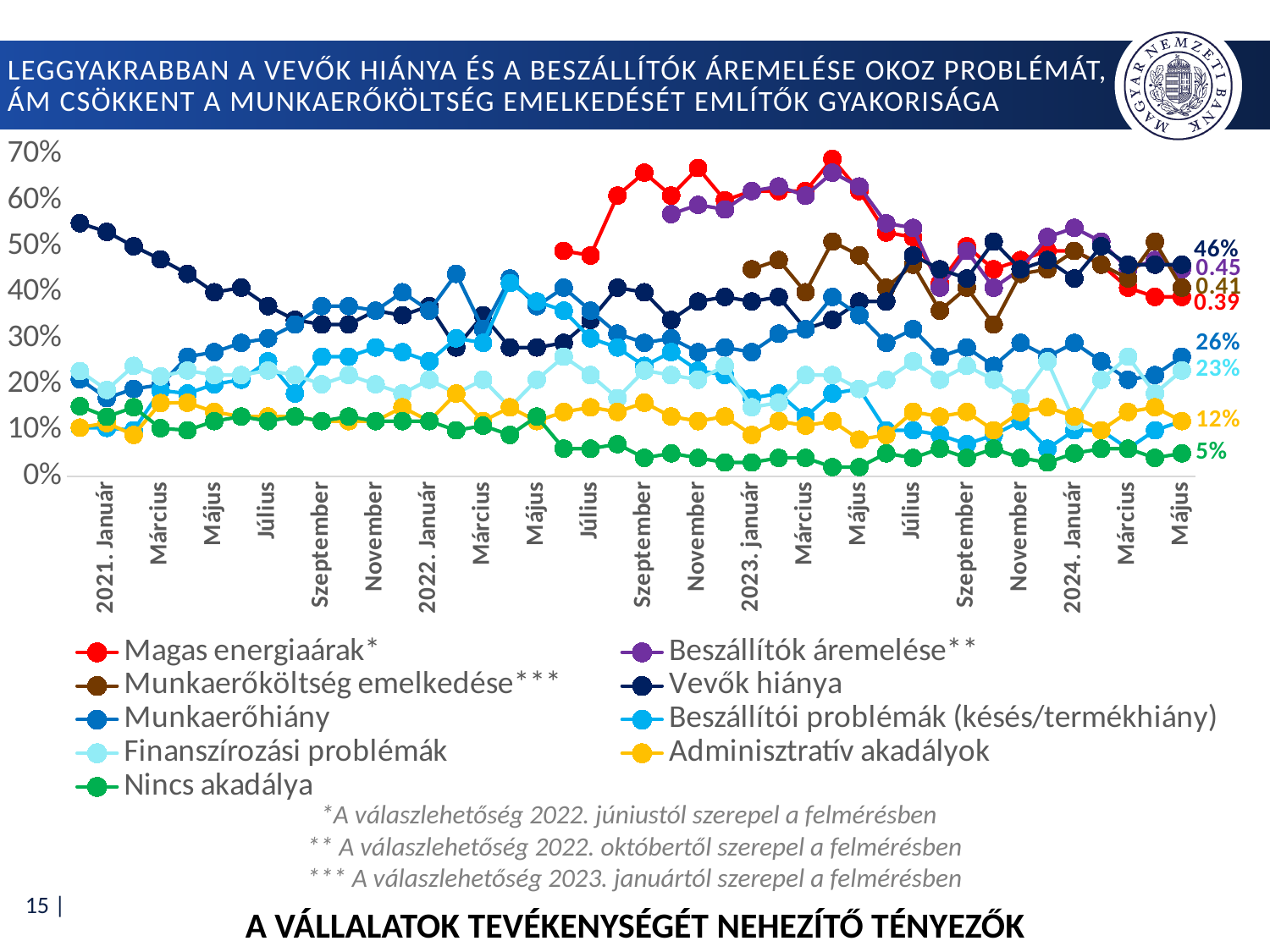
How many series does the legend list? 9 What is the title of the chart shown at the bottom of the slide? A vállalatok tevékenységét nehezítő tényezők What is the latest (May 2024) value for Vevők hiánya? 46% What is the latest (May 2024) value for Nincs akadálya? 5% What is the latest (May 2024) value for Munkaerőhiány? 26% At May 2024, which is larger: Vevők hiánya or Nincs akadálya? Vevők hiánya Is the value for Vevők hiánya in 2021. Január greater or less than 50%? greater What is the latest (May 2024) value labelled for Magas energiaárak? 0.39 What is the latest (May 2024) value for Finanszírozási problémák? 23% What kind of chart is shown on the slide? line chart What is the latest (May 2024) value for Adminisztratív akadályok? 12% What is the difference between the May 2024 values of Vevők hiánya (46%) and Nincs akadálya (5%)? 41 percentage points